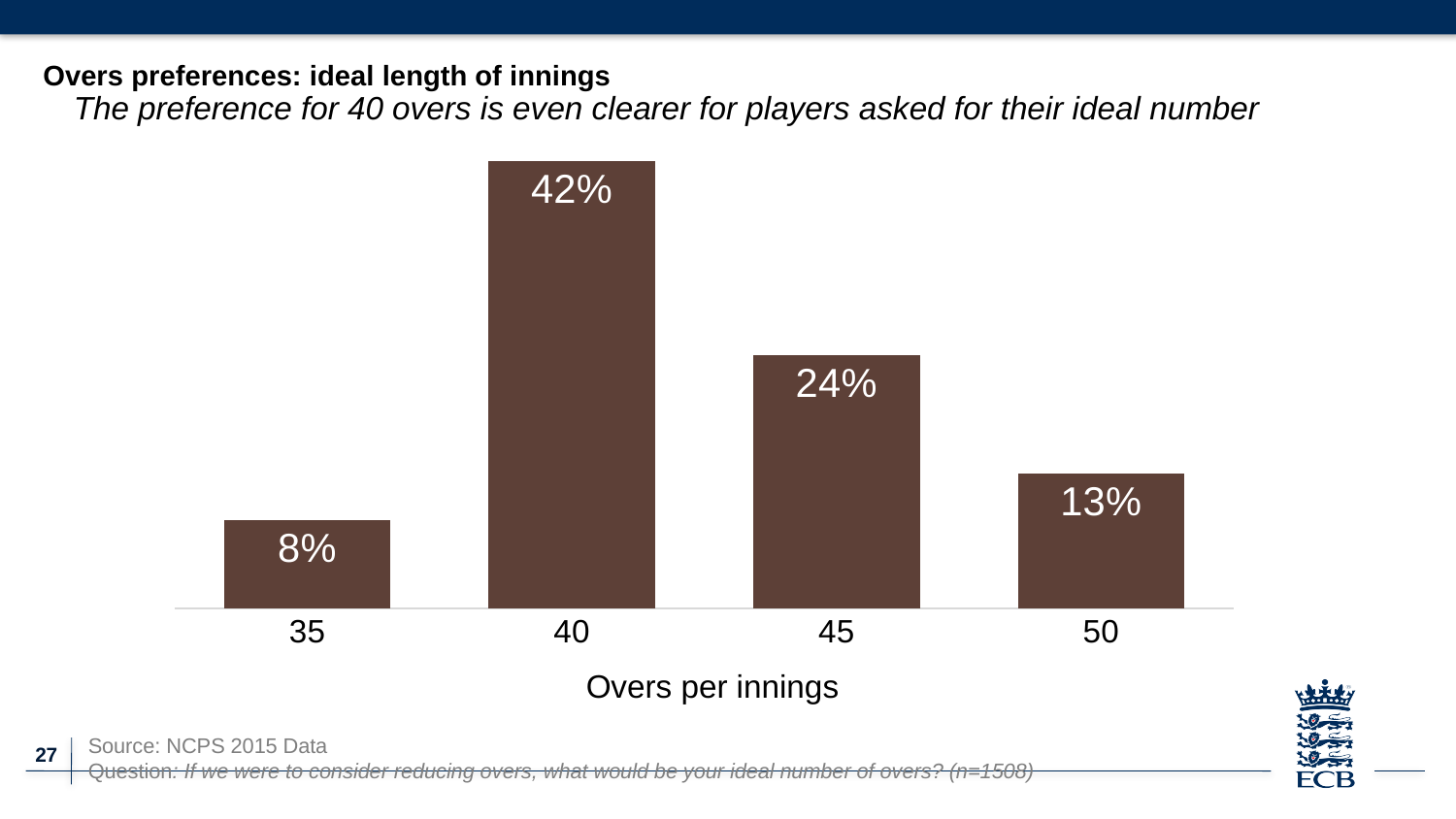
Which has a larger percentage, 45 overs or 50 overs? 45 What percentage of players chose 40 overs per innings as their ideal? 42% What type of chart is shown on the slide? Bar chart What is the value shown for 35 overs per innings? 8% Which overs-per-innings option has the highest percentage? 40 Which overs-per-innings option has the lowest percentage? 35 How many overs-per-innings categories are shown in the chart? 4 What is the label of the x axis? Overs per innings What is the value shown for 50 overs per innings? 13% What is the difference between the percentages for 50 overs and 35 overs? 5% What is the difference between the percentages for 40 overs and 45 overs? 18% What is the title of the slide? Overs preferences: ideal length of innings